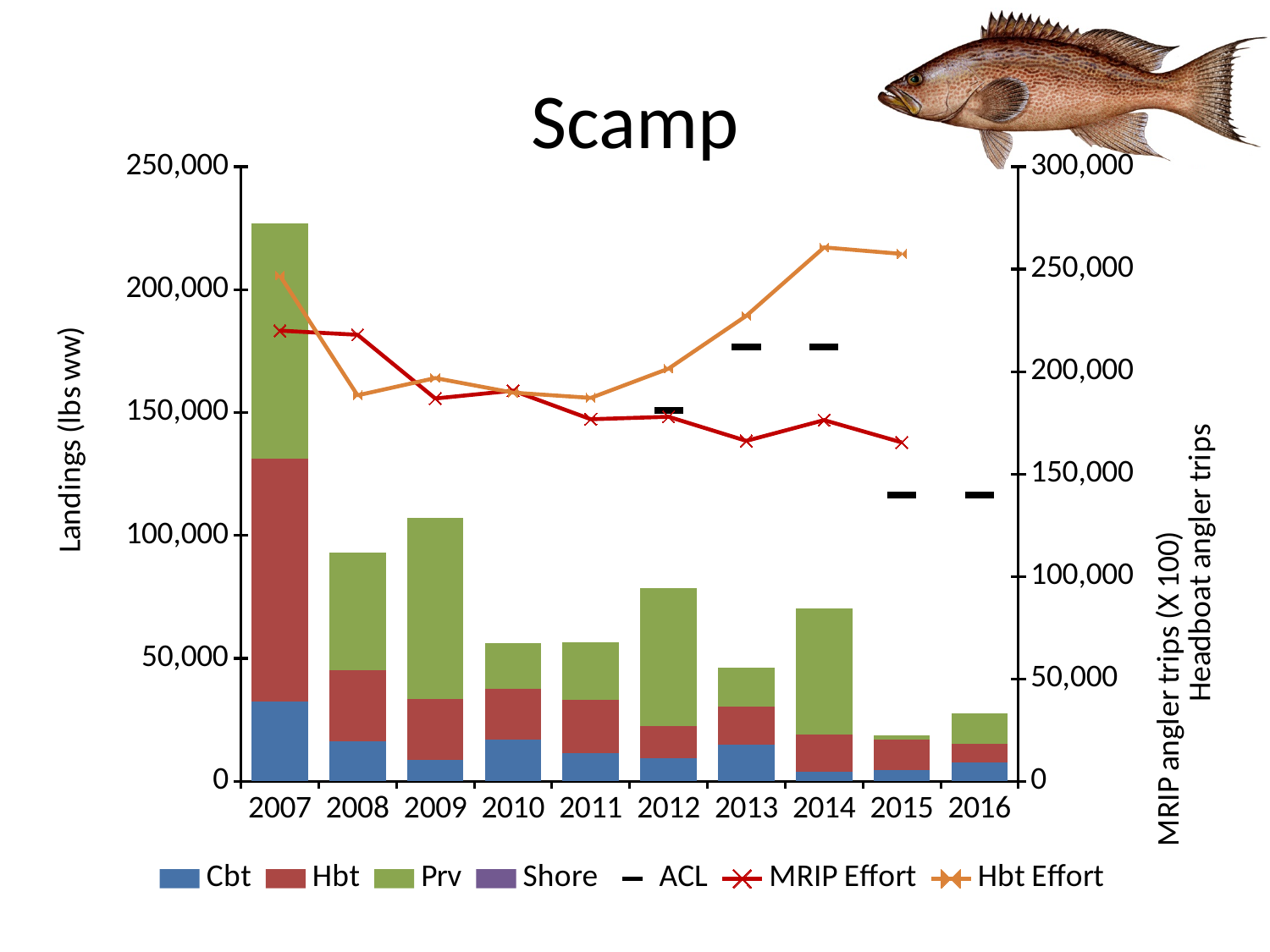
Is the Hbt Effort value for 2014 greater or less than 250,000 on the right axis? greater Is the total landings value for 2008 greater or less than 100,000? less What kind of chart is shown on the slide? Stacked bar chart with line series Does the Hbt Effort line rise or fall from 2011 to 2014? rise Which year has the lowest total landings? 2015 Which year has the highest total landings? 2007 Is the MRIP Effort value for 2015 greater or less than 200,000 on the right axis? less Which year has a larger total landings value, 2013 or 2014? 2014 How many series does the legend list? 7 What is the title of the chart? Scamp How many years are shown on the x axis? 10